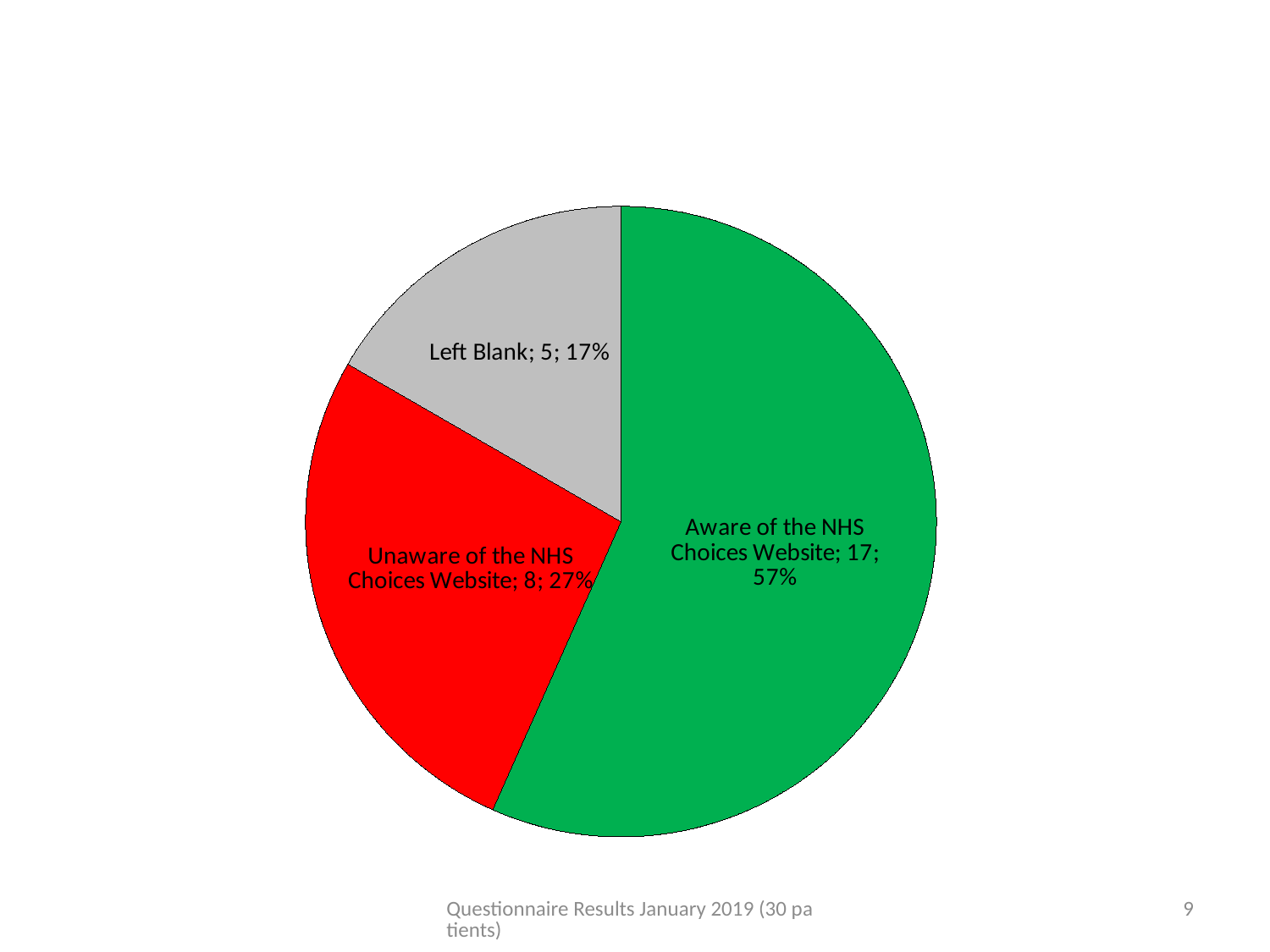
What percentage of the pie is the 'Left Blank' slice? 17% How many patients were unaware of the NHS Choices Website? 8 What colour is the 'Unaware of the NHS Choices Website' slice? red What is the difference in count between 'Aware of the NHS Choices Website' and 'Unaware of the NHS Choices Website'? 9 What kind of chart is shown on the slide? pie chart Which is larger, the 'Unaware of the NHS Choices Website' slice or the 'Left Blank' slice? Unaware of the NHS Choices Website Which category has the largest slice of the pie? Aware of the NHS Choices Website How many slices does the pie chart have? 3 How many responses were left blank? 5 How many patients were aware of the NHS Choices Website? 17 What percentage of the pie is the 'Aware of the NHS Choices Website' slice? 57% Which category has the smallest slice of the pie? Left Blank